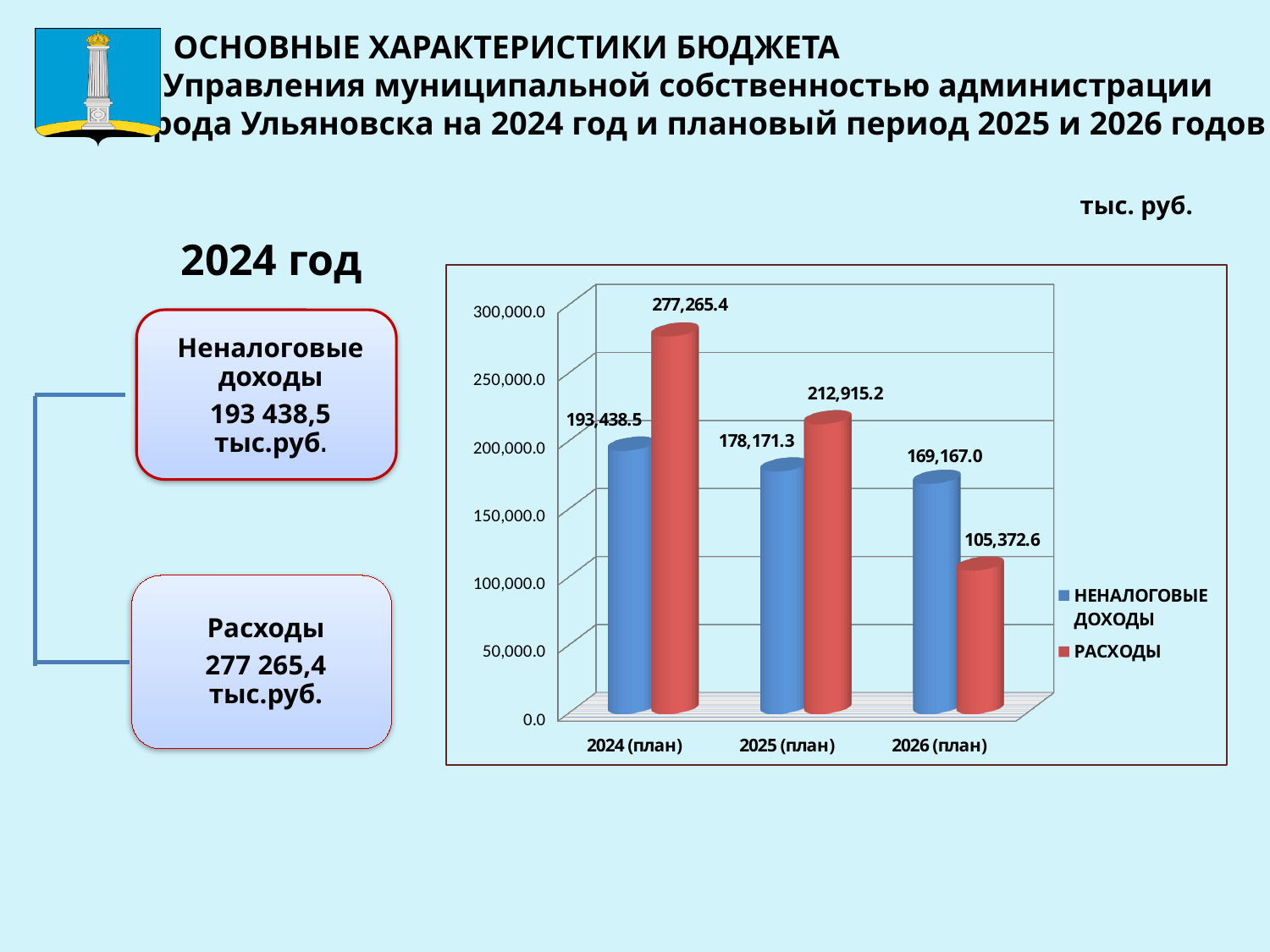
What is the value of РАСХОДЫ for 2025 (план)? 212,915.2 Which is larger in 2026 (план): НЕНАЛОГОВЫЕ ДОХОДЫ or РАСХОДЫ? НЕНАЛОГОВЫЕ ДОХОДЫ In which year is РАСХОДЫ the highest? 2024 (план) What is the difference between НЕНАЛОГОВЫЕ ДОХОДЫ in 2024 (план) and 2025 (план)? 15,267.2 How many series does the legend list? 2 In which year is НЕНАЛОГОВЫЕ ДОХОДЫ the lowest? 2026 (план) Is the value of РАСХОДЫ for 2025 (план) greater or less than 200,000.0? greater Does РАСХОДЫ rise or fall from 2024 (план) to 2026 (план)? fall What is the value of НЕНАЛОГОВЫЕ ДОХОДЫ for 2024 (план)? 193,438.5 What is the value of РАСХОДЫ for 2026 (план)? 105,372.6 What is the difference between РАСХОДЫ and НЕНАЛОГОВЫЕ ДОХОДЫ in 2024 (план)? 83,826.9 How many years (categories) are shown on the x axis? 3